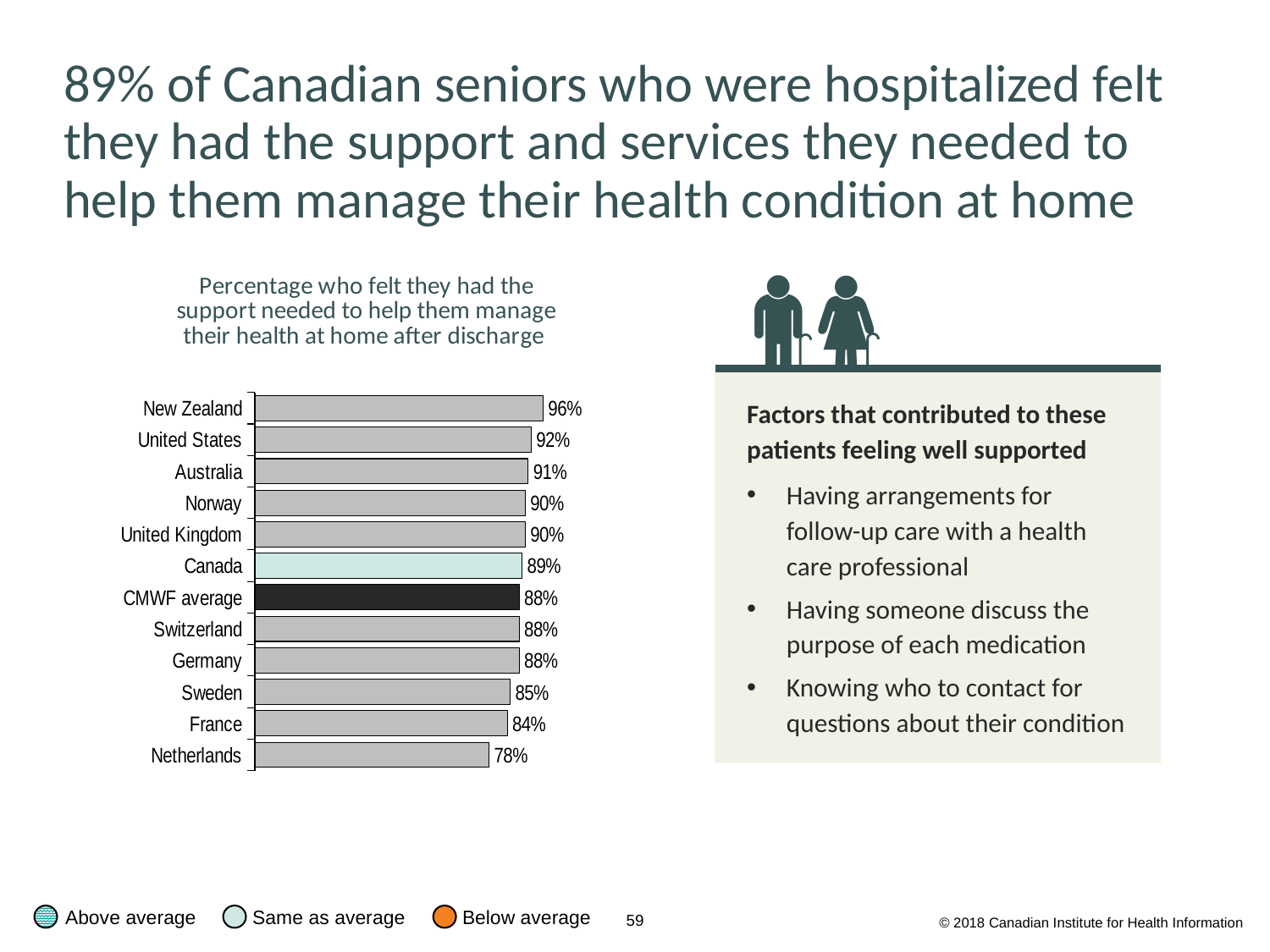
Which bar is shaded in a different, lighter colour from the other country bars? Canada Which is larger, the value for Sweden or the value for France? Sweden What is the value for the United States? 92% How many bars are shown in the chart? 12 What is the value for the Netherlands? 78% What kind of chart is shown on the slide? Bar chart What is the difference between New Zealand and the Netherlands? 18 percentage points Which country has the lowest percentage? Netherlands What is the value for the CMWF average? 88% What is the difference between Canada and the CMWF average? 1 percentage point Which country has the highest percentage? New Zealand What is the value for Canada? 89%